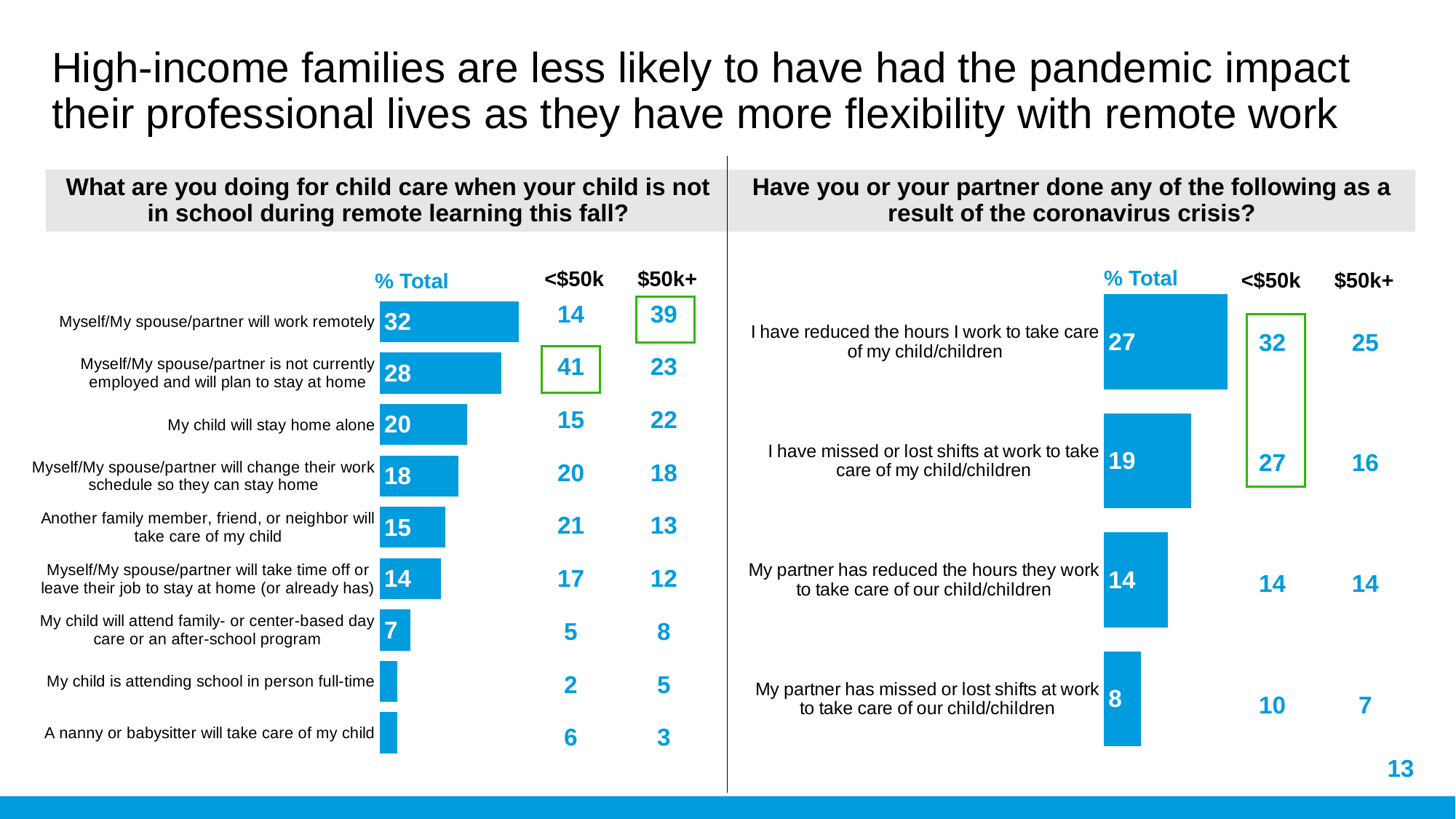
In the right chart on the coronavirus crisis, what is the difference between the <$50k and $50k+ values for "I have missed or lost shifts at work to take care of my child/children"? 11 In the left chart on child care during remote learning, which category has the highest % Total? Myself/My spouse/partner will work remotely In the left chart on child care during remote learning, is the <$50k value or the $50k+ value larger for "Another family member, friend, or neighbor will take care of my child"? <$50k In the left chart on child care during remote learning, what is the <$50k value for "Myself/My spouse/partner is not currently employed and will plan to stay at home"? 41 In the left chart on child care during remote learning, what is the difference between the $50k+ and <$50k values for "Myself/My spouse/partner will work remotely"? 25 In the right chart on the coronavirus crisis, which category has the lowest % Total? My partner has missed or lost shifts at work to take care of our child/children What type of chart is used on the left side of the slide to show the % Total values? Bar chart In the right chart on the coronavirus crisis, what is the <$50k value for "I have missed or lost shifts at work to take care of my child/children"? 27 In the right chart on the coronavirus crisis, what is the % Total for "I have reduced the hours I work to take care of my child/children"? 27 In the right chart on the coronavirus crisis, how many categories are shown? 4 In the left chart on child care during remote learning, what is the % Total for "Myself/My spouse/partner will work remotely"? 32 In the left chart on child care during remote learning, how many categories are listed? 9